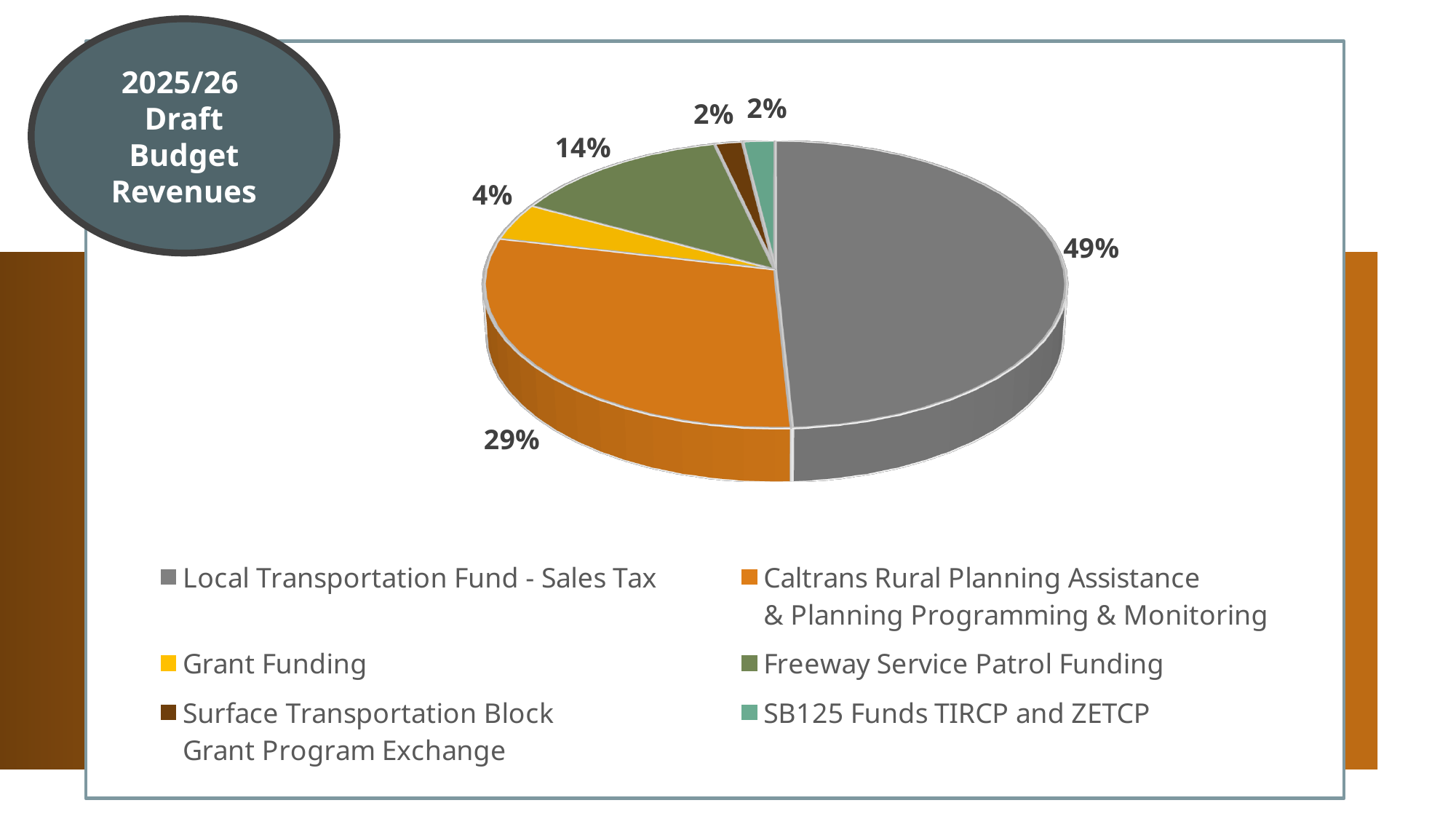
What kind of chart is shown on the slide? Pie chart What colour is the slice for Grant Funding? Yellow What is the difference in percentage points between Local Transportation Fund - Sales Tax and Caltrans Rural Planning Assistance & Planning Programming & Monitoring? 20 percentage points Which category has the largest slice of the pie? Local Transportation Fund - Sales Tax What share of the pie does Caltrans Rural Planning Assistance & Planning Programming & Monitoring represent? 29% What is the title shown in the circle on the slide? 2025/26 Draft Budget Revenues How many categories does the legend list? 6 Which is larger, Freeway Service Patrol Funding or Grant Funding? Freeway Service Patrol Funding What share of the pie does Local Transportation Fund - Sales Tax represent? 49% What share of the pie does Grant Funding represent? 4%